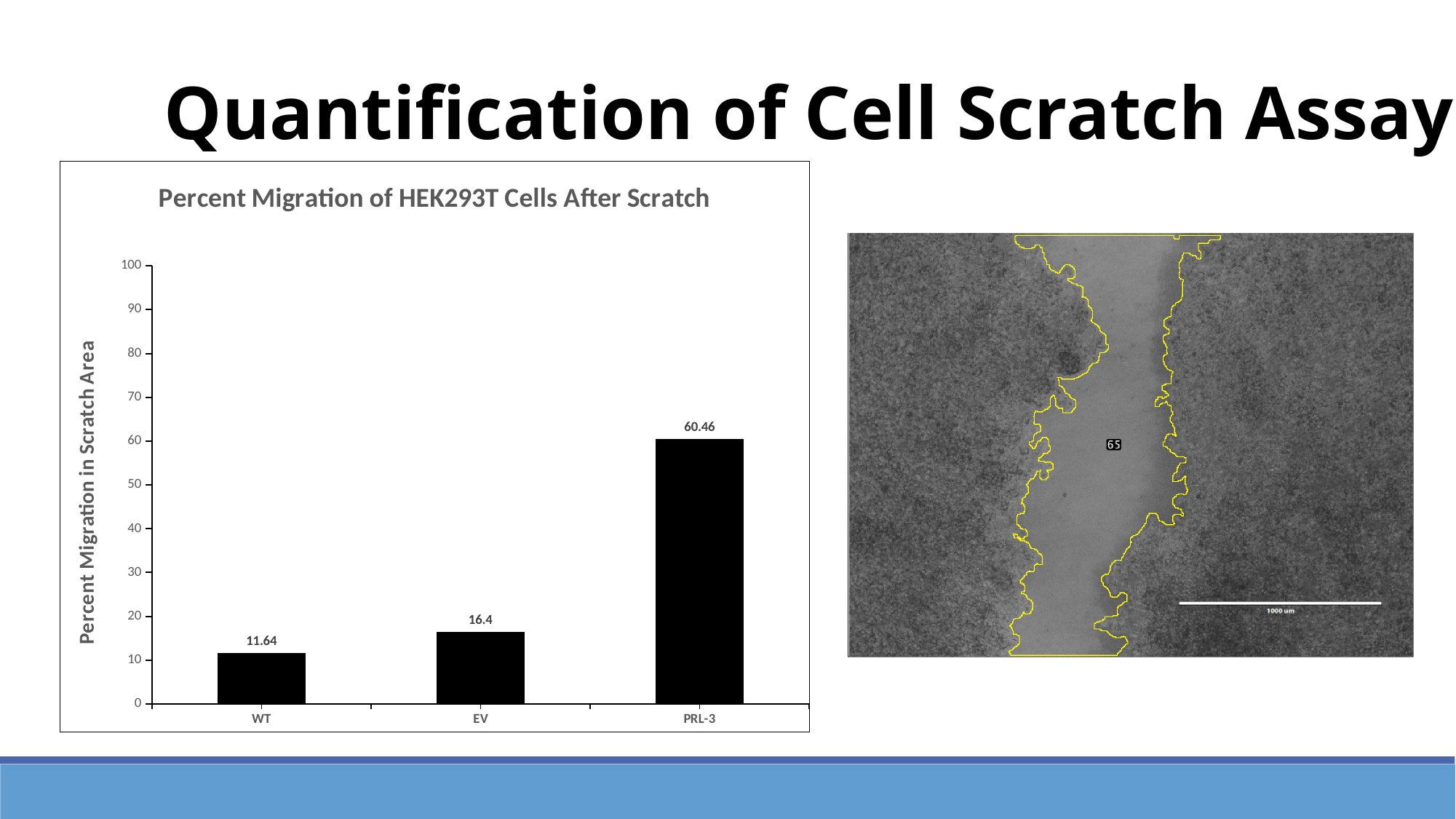
What is the value for PRL-3? 60.46 What kind of chart is shown? bar chart What is the difference between the values for EV and WT? 4.76 What is the difference between the values for PRL-3 and EV? 44.06 Is the value for PRL-3 greater or less than 50? greater Which category has the lowest percent migration? WT Which is larger, the value for EV or the value for WT? EV What is the title of the chart? Percent Migration of HEK293T Cells After Scratch How many categories are shown on the x axis? 3 What is the value for EV? 16.4 Which category has the highest percent migration? PRL-3 What is the value for WT? 11.64